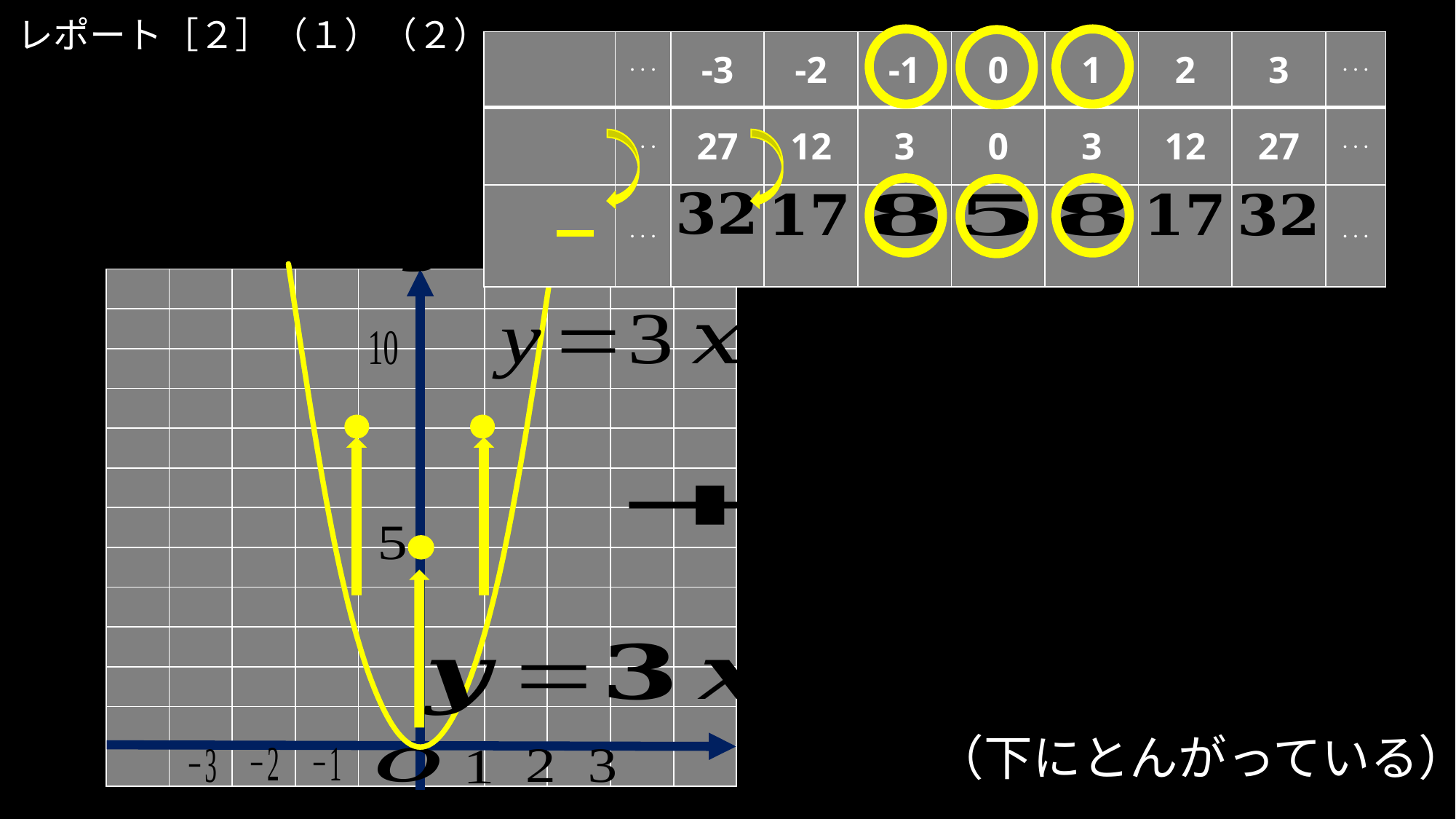
In the table, what is the difference between the third-row value and the second-row value at x = 1? 5 What kind of graph is drawn in the lower-left of the slide? a line (curve) graph of a parabola On the graph, is the y value of the marked point at x = 1 on the curve greater or less than 5? greater In the table, do the second-row values rise or fall as x goes from -3 to 0? fall In the table, what value is shown in the third row for x = 2? 17 In the table, what value is shown in the second row for x = -3? 27 In the table, what is the largest value shown in the third row? 32 In the table, what value is shown in the third row for x = 0? 5 In the table, what value is shown in the second row for x = 1? 3 How many x values (excluding the ellipses) are listed in the table's header row? 7 In the table, which is larger in the second row: the value at x = -2 or the value at x = -1? x = -2 In the table, at which x value is the second row's value smallest? 0